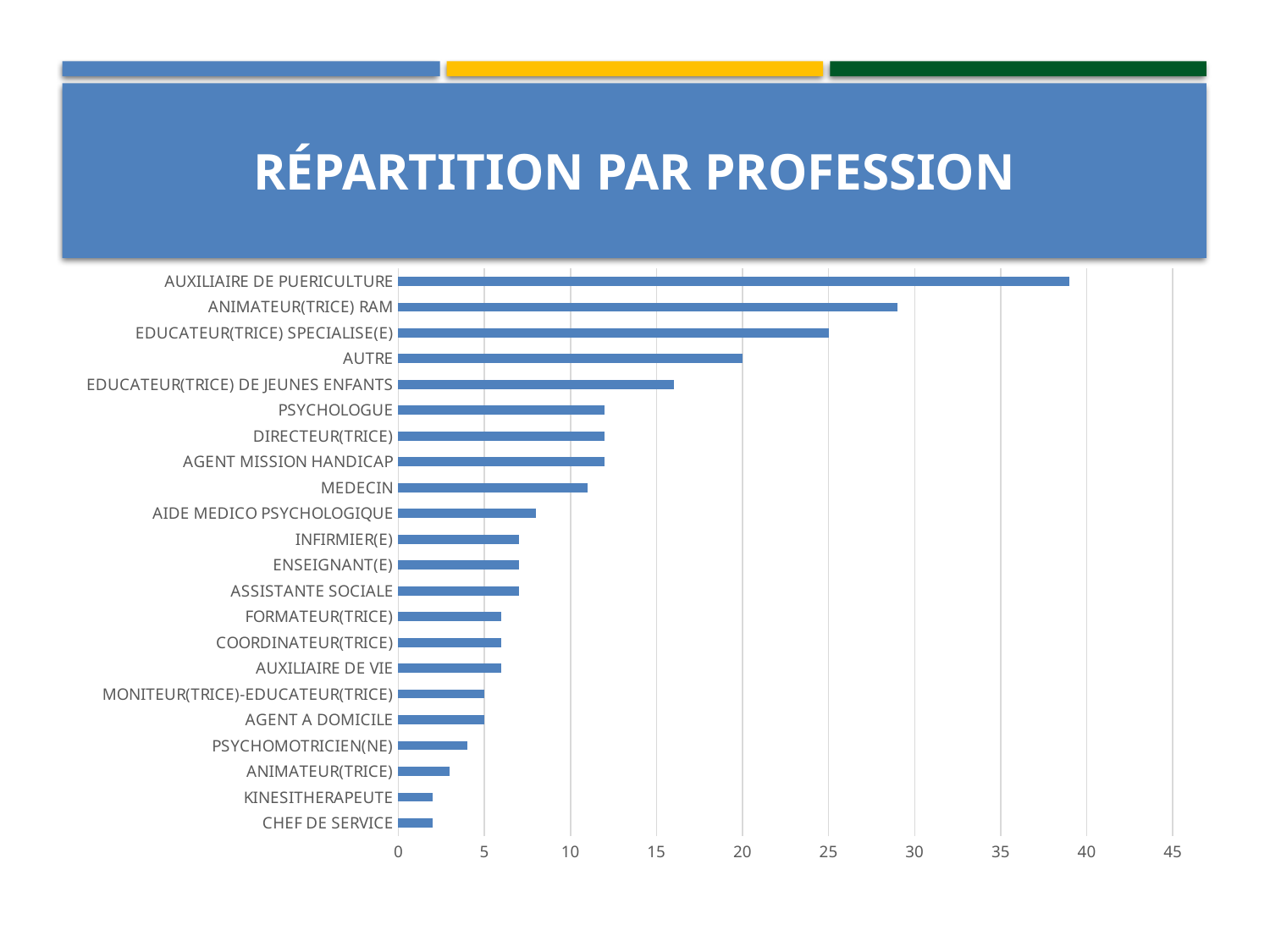
Is the value for PSYCHOMOTRICIEN(NE) greater or less than 5? less Is the value for AUXILIAIRE DE PUERICULTURE greater or less than 35? greater What is the value for AUTRE? 20 How many professions are listed on the chart? 22 Is the value for AIDE MEDICO PSYCHOLOGIQUE greater or less than 10? less Which profession has the highest value? AUXILIAIRE DE PUERICULTURE Which has the larger value, ANIMATEUR(TRICE) RAM or AUTRE? ANIMATEUR(TRICE) RAM What kind of chart is shown on the slide? bar chart What is the title of the chart? RÉPARTITION PAR PROFESSION Which has the larger value, MEDECIN or AIDE MEDICO PSYCHOLOGIQUE? MEDECIN